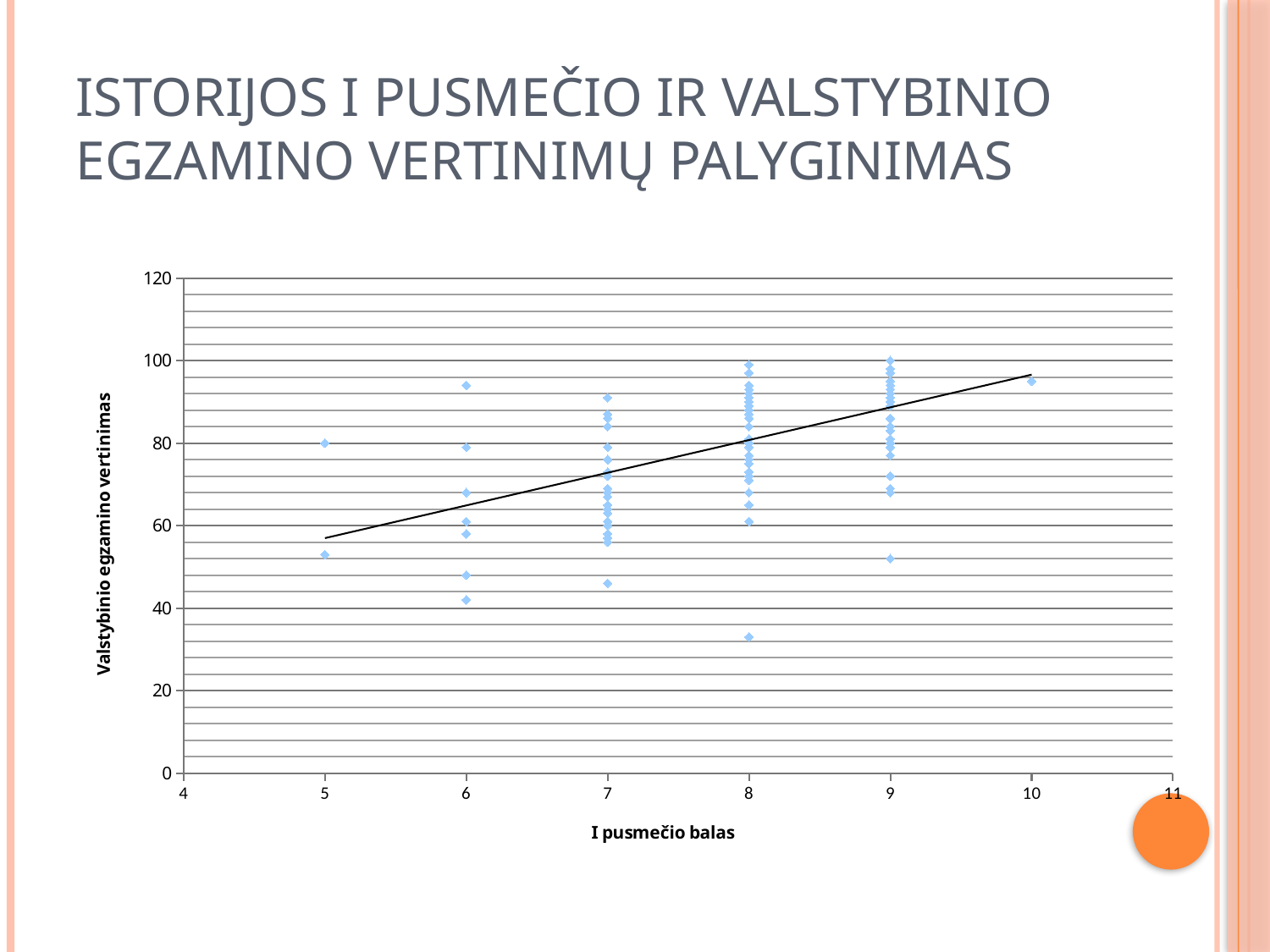
How many points are plotted at x = 5? 2 Is the highest point plotted at x = 9 greater or less than 80? greater Does the trend line rise or fall as the x axis value (I pusmečio balas) increases? rises Is the lowest point plotted at x = 8 greater or less than 40? less Is the highest point plotted at x = 6 greater or less than 80? greater At which x axis value (I pusmečio balas) is the single lowest point on the chart plotted? 8 What is the title of the horizontal axis? I pusmečio balas How many points are plotted at x = 10? 1 What is the title of the vertical axis? Valstybinio egzamino vertinimas What kind of chart is shown on the slide? scatter chart